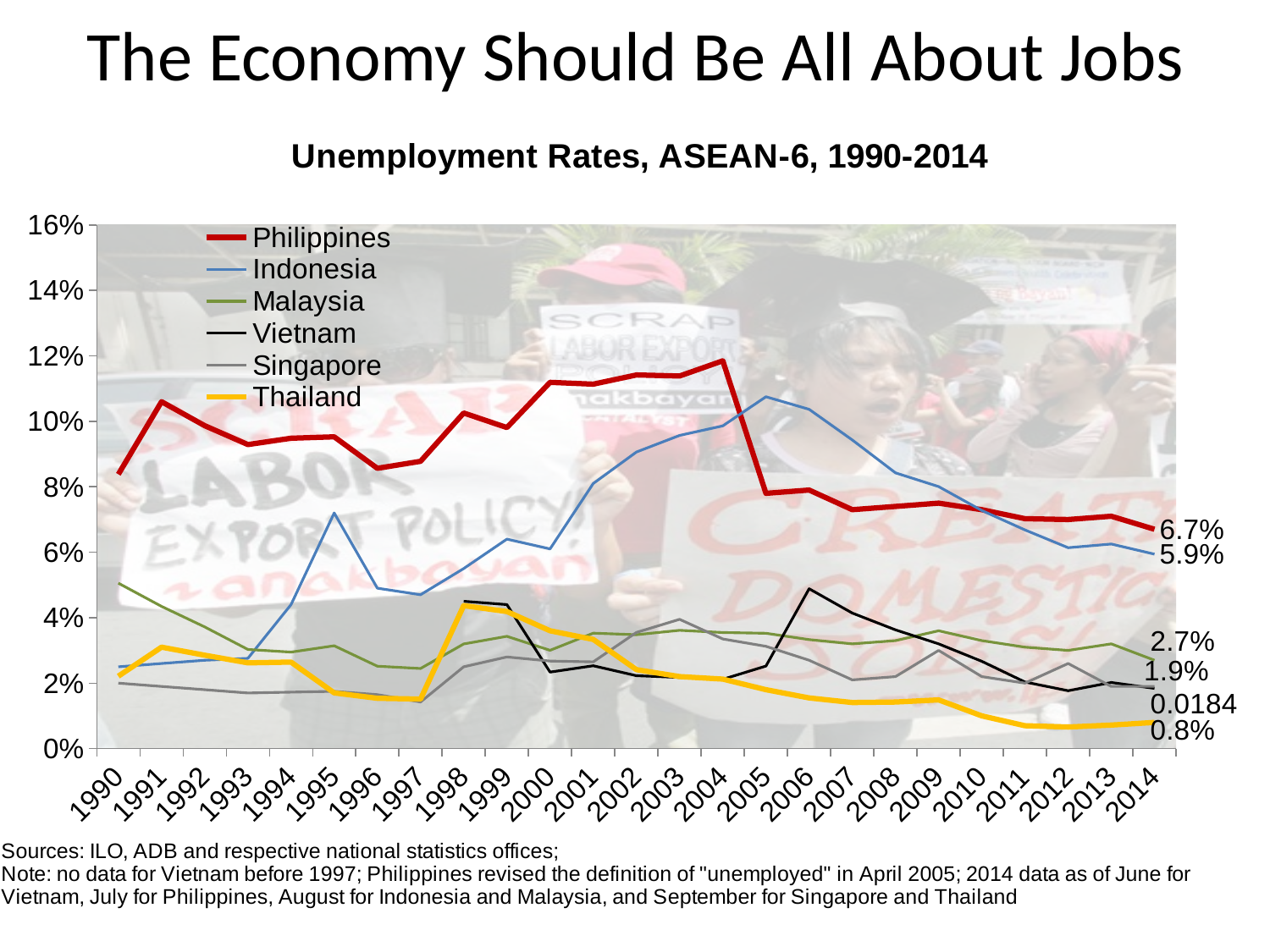
Does the Philippines unemployment rate rise or fall from 2005 to 2014? fall Which country has the highest unemployment rate in 2014? Philippines What type of chart is shown on the slide? line chart What is the unemployment rate for Thailand in 2014? 0.8% Which country had the higher unemployment rate in 2006, the Philippines or Indonesia? Indonesia What is the unemployment rate for Indonesia in 2014? 5.9% What is the unemployment rate for Malaysia in 2014? 2.7% Is the unemployment rate for the Philippines in 2004 greater or less than 10%? greater Which country has the lowest unemployment rate in 2014? Thailand What is the unemployment rate for the Philippines in 2014? 6.7% What is the difference between the Philippines and Indonesia unemployment rates in 2014? 0.8% How many series does the legend list? 6